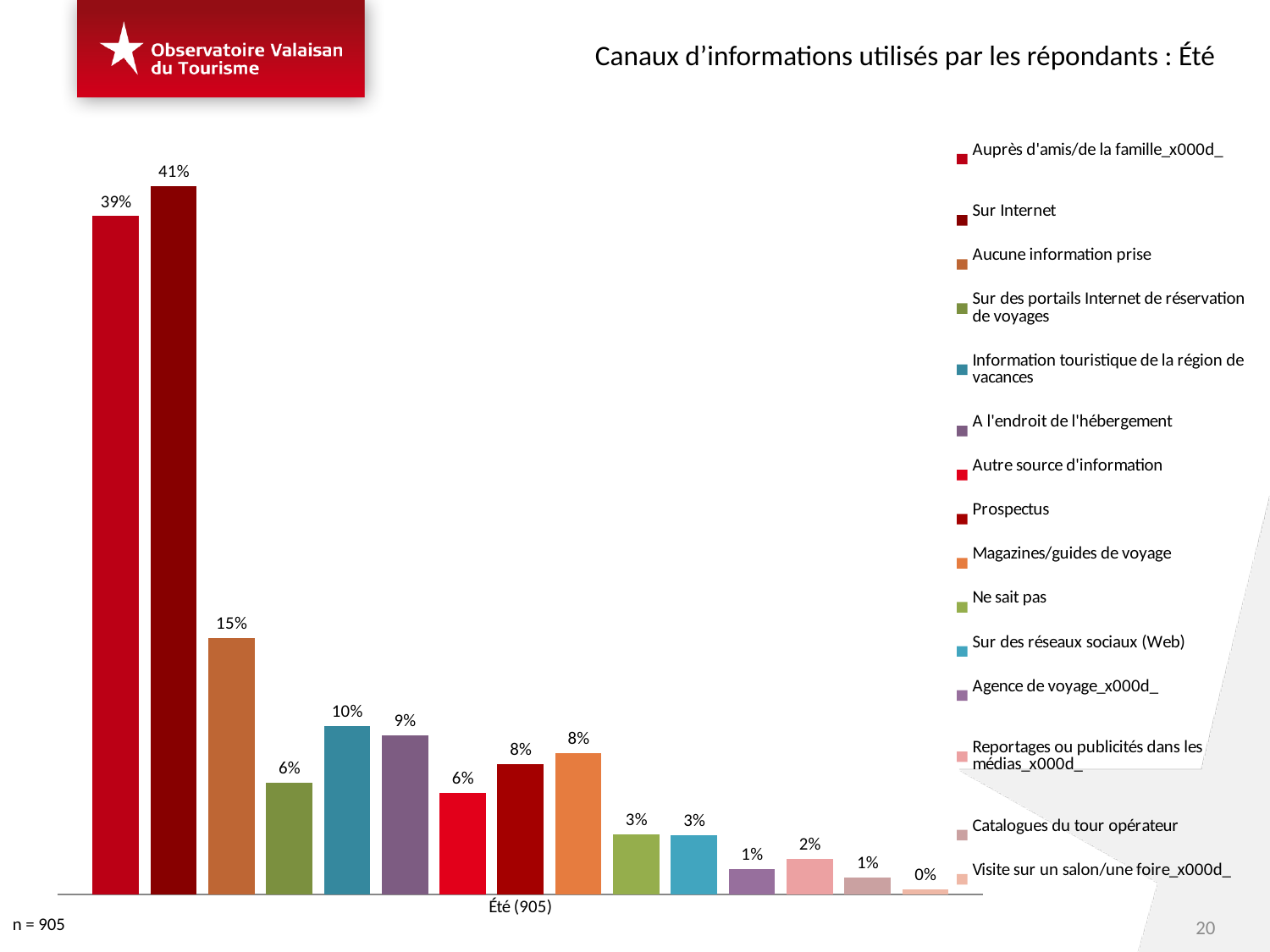
What is the difference between the values for Sur Internet and Auprès d'amis/de la famille? 2% Which information channel has the highest value? Sur Internet What is the value for Aucune information prise? 15% What is the title of the chart? Canaux d'informations utilisés par les répondants : Été What is the value for Auprès d'amis/de la famille? 39% Which is larger, the value for A l'endroit de l'hébergement or the value for Prospectus? A l'endroit de l'hébergement What kind of chart is shown on the slide? Bar chart What is the value for Sur Internet? 41% What is the value for Information touristique de la région de vacances? 10% How many series does the legend list? 15 What is the value for Sur des réseaux sociaux (Web)? 3% Which information channel has the lowest value? Visite sur un salon/une foire